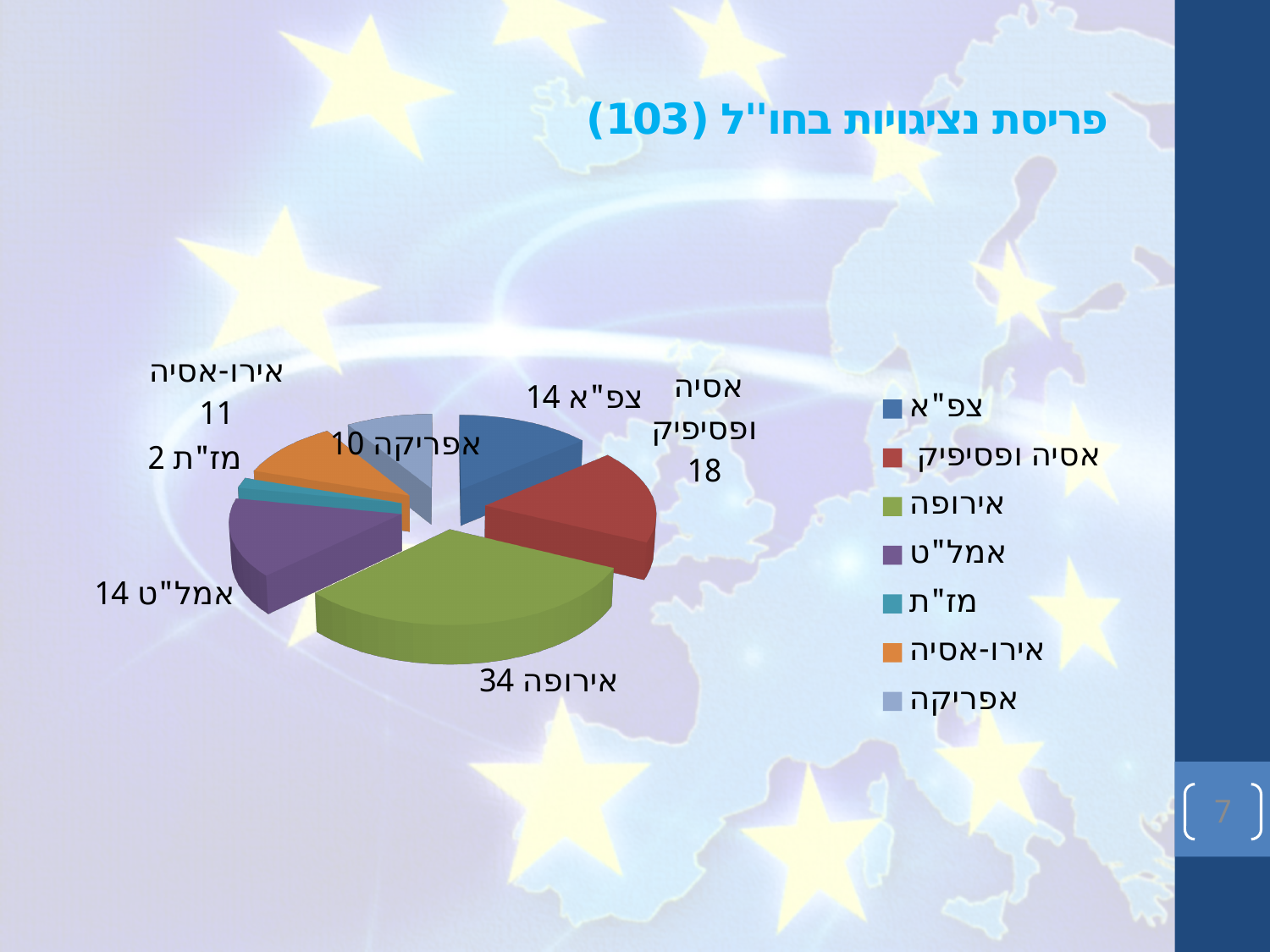
Which is larger, the value for אירו-אסיה or the value for אפריקה? אירו-אסיה What is the title of the chart? פריסת נציגויות בחו''ל (103) How many categories does the pie chart have? 7 What is the value for אירופה in the pie chart? 34 What type of chart is shown on the slide? Pie chart What is the difference between the values for אירופה and אסיה ופסיפיק? 16 What is the value for אסיה ופסיפיק in the pie chart? 18 Which category has the smallest slice in the pie chart? מז"ת What is the value for אפריקה in the pie chart? 10 What is the total of all slices in the pie chart? 103 Which category has the largest slice in the pie chart? אירופה What is the value for אירו-אסיה in the pie chart? 11